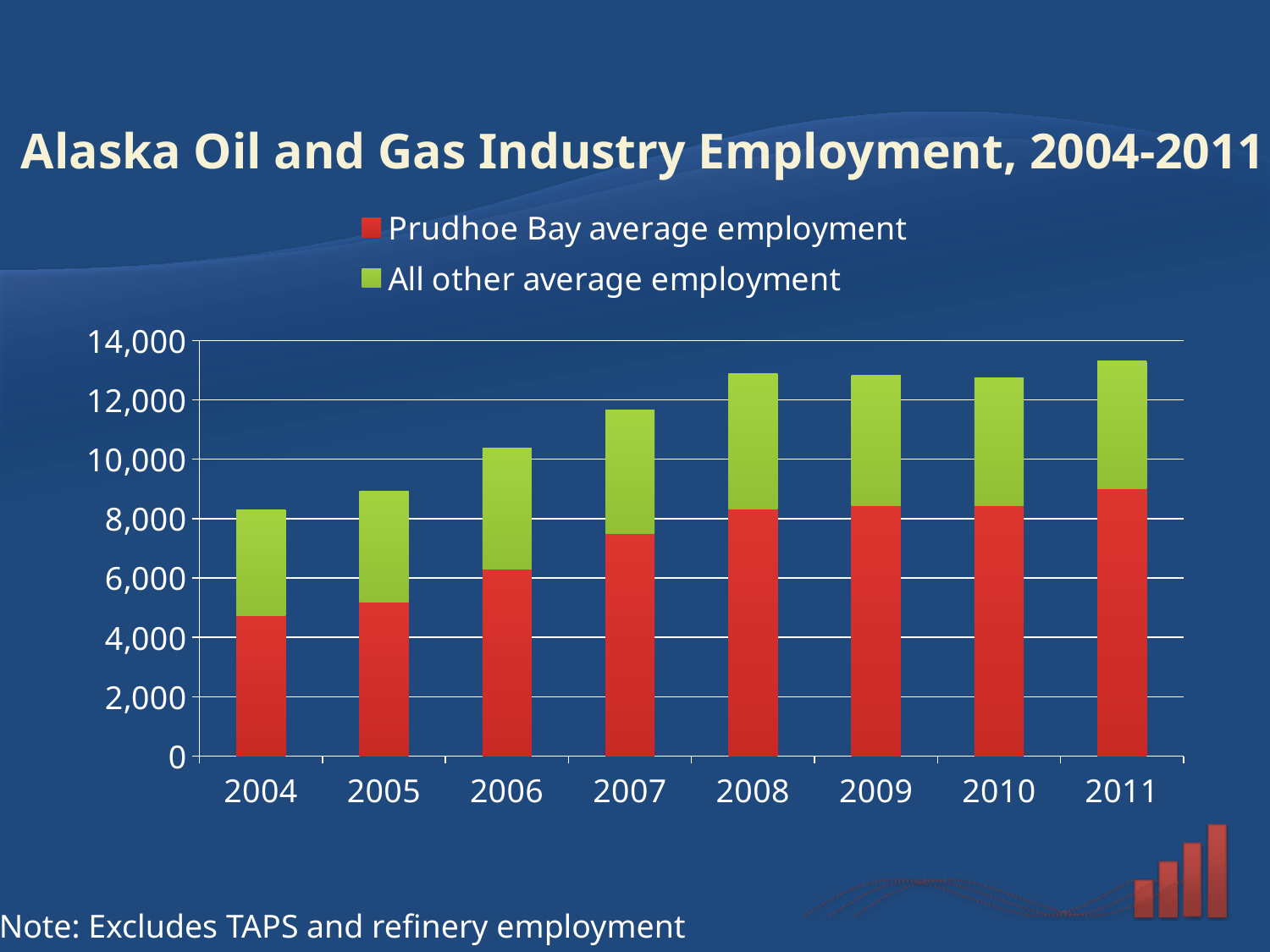
How many series does the legend list? 2 Is the total employment for 2004 greater or less than 10,000? less What kind of chart is shown on the slide? Stacked bar chart Which year has the lowest Prudhoe Bay average employment? 2004 Is the total employment for 2007 greater or less than 10,000? greater How many years are shown on the x axis? 8 Is the Prudhoe Bay average employment for 2004 greater or less than 4,000? greater Which year has the highest total employment? 2011 Is total employment higher in 2008 or in 2004? 2008 Which year has the lowest total employment? 2004 Which year has the highest Prudhoe Bay average employment? 2011